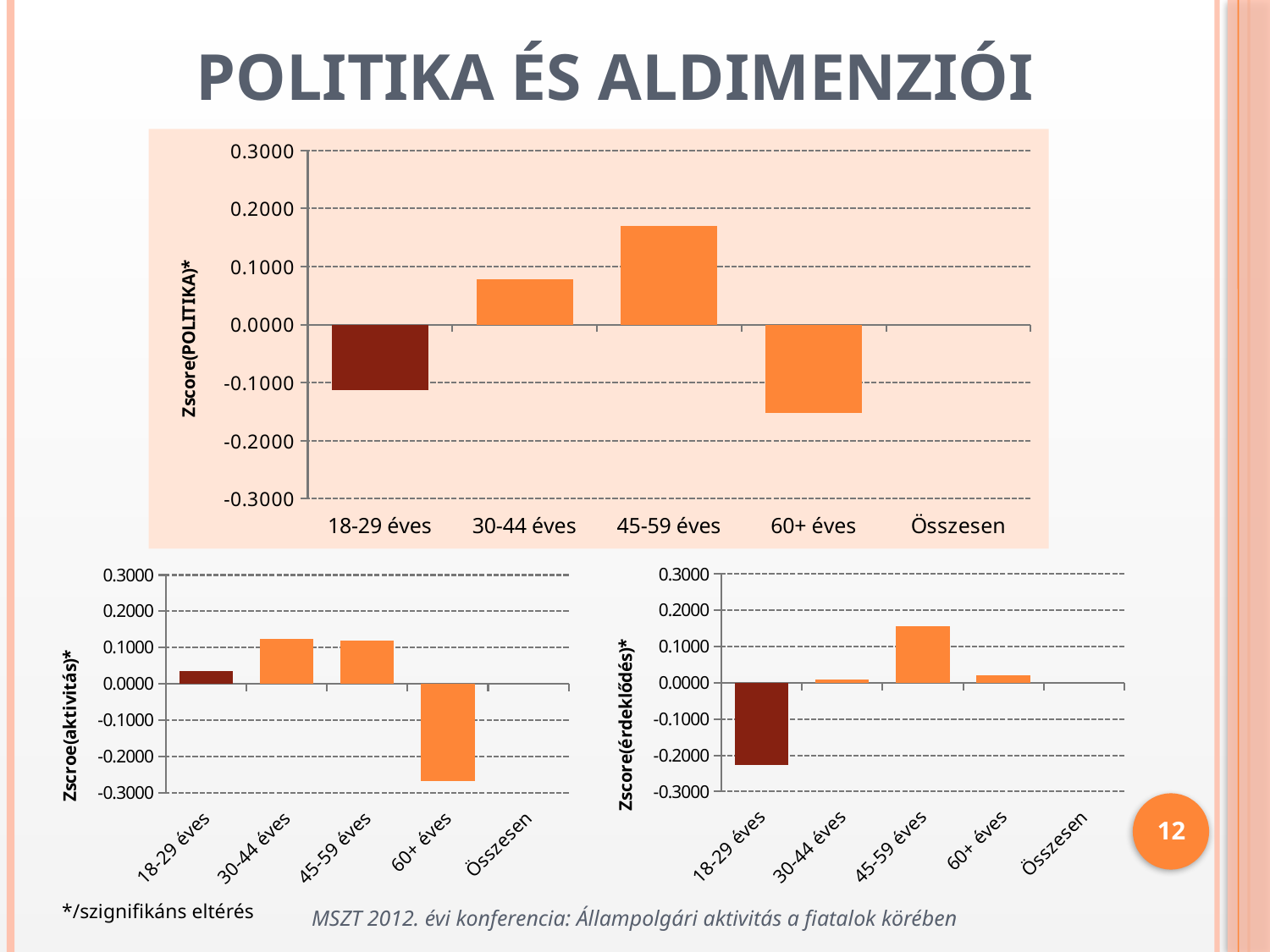
In the top chart (Zscore(POLITIKA)*), is the value for 60+ éves greater or less than -0.1000? less In the bottom-left chart (Zscroe(aktivitás)*), which age group has the lowest value? 60+ éves How many categories are shown on the x axis of the top chart (Zscore(POLITIKA)*)? 5 In the top chart (Zscore(POLITIKA)*), is the value for 45-59 éves greater or less than 0.1000? greater In the bottom-left chart (Zscroe(aktivitás)*), is the value for 60+ éves greater or less than -0.2000? less What kind of chart is the top chart (Zscore(POLITIKA)*)? bar chart In the bottom-left chart (Zscroe(aktivitás)*), which is larger, the value for 18-29 éves or for 30-44 éves? 30-44 éves In the top chart (Zscore(POLITIKA)*), which age group has the lowest value? 60+ éves What is the y-axis title of the top chart? Zscore(POLITIKA)* In the bottom-right chart (Zscore(érdeklődés)*), which age group has the lowest value? 18-29 éves In the top chart (Zscore(POLITIKA)*), which age group has the highest value? 45-59 éves In the bottom-right chart (Zscore(érdeklődés)*), which age group has the highest value? 45-59 éves